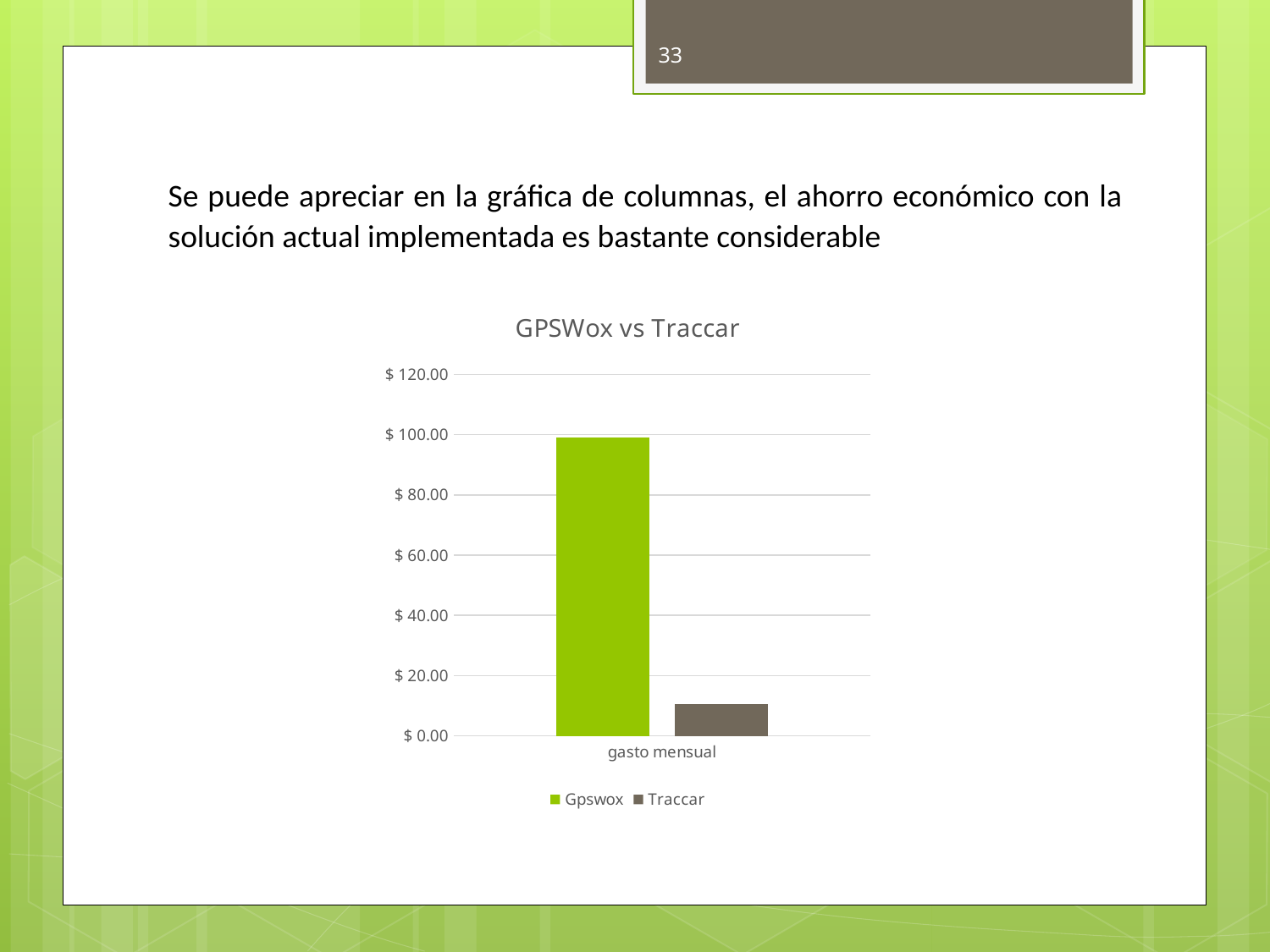
What is the label of the category on the x axis? gasto mensual Is the value for Gpswox greater or less than $ 120.00? less Which series has the highest value for gasto mensual? Gpswox What is the title of the chart? GPSWox vs Traccar What kind of chart is shown on the slide? bar chart Which is larger for gasto mensual, Gpswox or Traccar? Gpswox How many series does the legend list? 2 Is the value for Traccar greater or less than $ 40.00? less Which series has the lowest value for gasto mensual? Traccar Is the value for Gpswox greater or less than $ 80.00? greater How many categories are shown on the x axis? 1